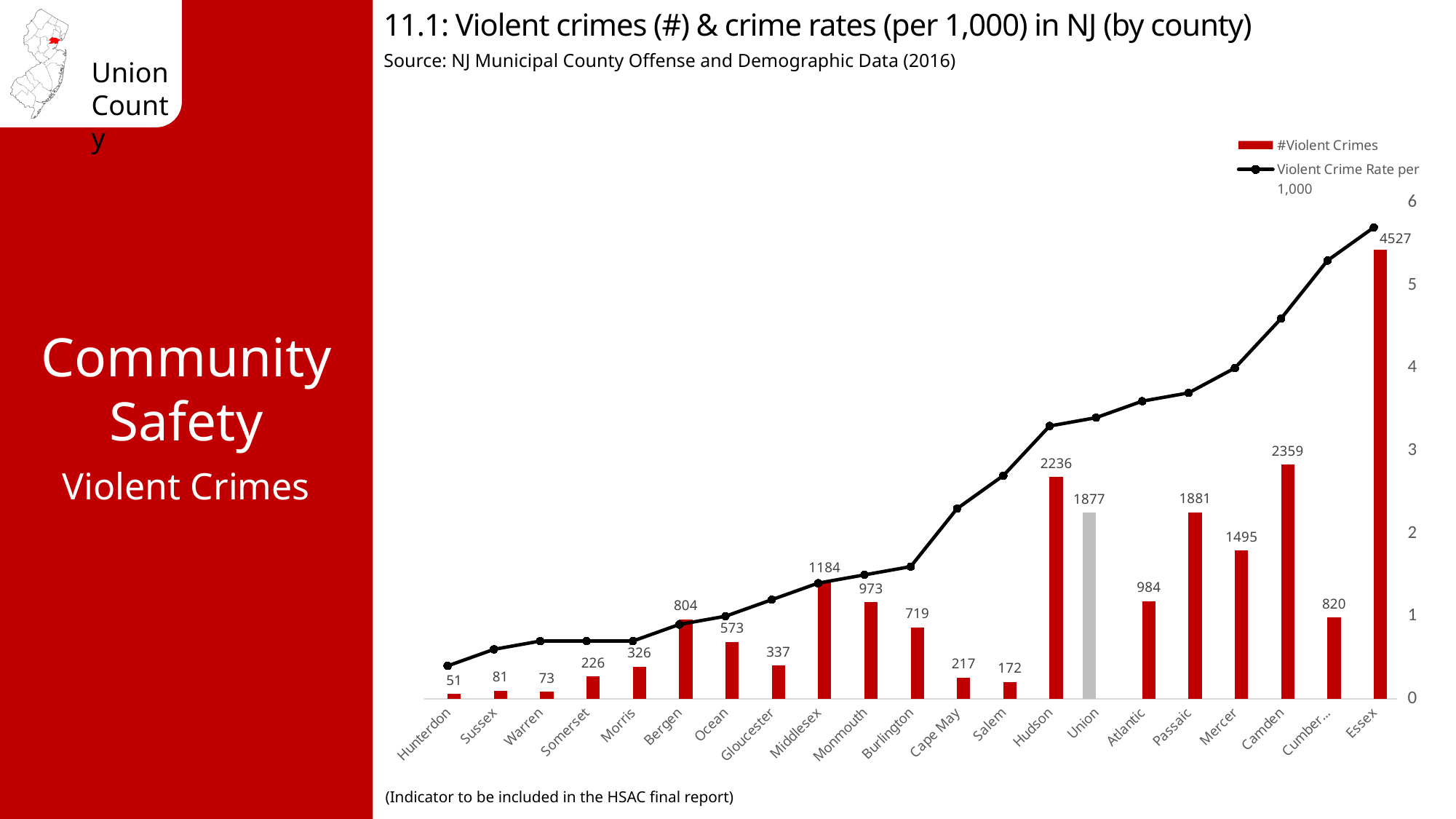
Is the violent crime rate per 1,000 for Hunterdon greater or less than 1? less Which county has the lowest number of violent crimes? Hunterdon How many counties are shown on the x axis of the chart? 21 How many violent crimes are shown for Union county? 1877 What is the number of violent crimes for Essex county? 4527 Which county's bar is coloured grey instead of red? Union Which county has the highest number of violent crimes? Essex What is the difference in the number of violent crimes between Hudson and Union? 359 Does the violent crime rate per 1,000 line generally rise or fall from Hunterdon to Essex? rise Is the violent crime rate per 1,000 for Essex greater or less than 5? greater How many series does the legend list? 2 Which county has more violent crimes, Camden or Passaic? Camden